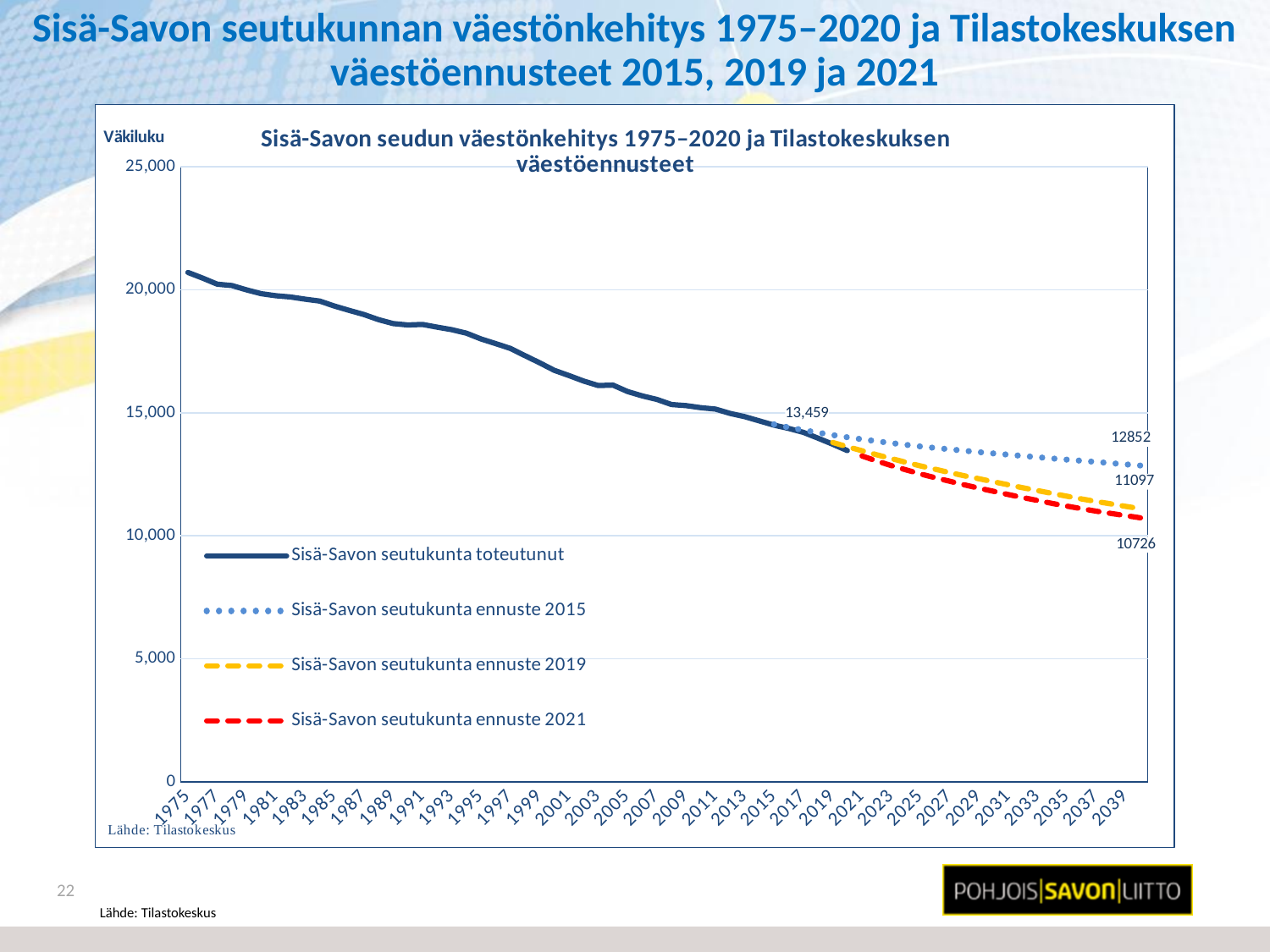
What is the final labelled value of the 'Sisä-Savon seutukunta ennuste 2021' series? 10726 How many series does the legend list? 4 What kind of chart is shown on the slide? line chart Which forecast series ends with the lowest labelled value? Sisä-Savon seutukunta ennuste 2021 What is the difference between the final labelled values of the 2019 forecast (11097) and the 2021 forecast (10726)? 371 Which forecast series ends with the highest labelled value? Sisä-Savon seutukunta ennuste 2015 Is the value of the 'Sisä-Savon seutukunta toteutunut' series in 1975 greater or less than 20,000? greater What value is printed as a data label near the year 2015 on the chart? 13,459 What is the difference between the final labelled values of the 2015 forecast (12852) and the 2021 forecast (10726)? 2126 What is the final labelled value of the 'Sisä-Savon seutukunta ennuste 2015' series? 12852 What is the final labelled value of the 'Sisä-Savon seutukunta ennuste 2019' series? 11097 Does the 'Sisä-Savon seutukunta toteutunut' series rise or fall from 1975 to 2020? fall